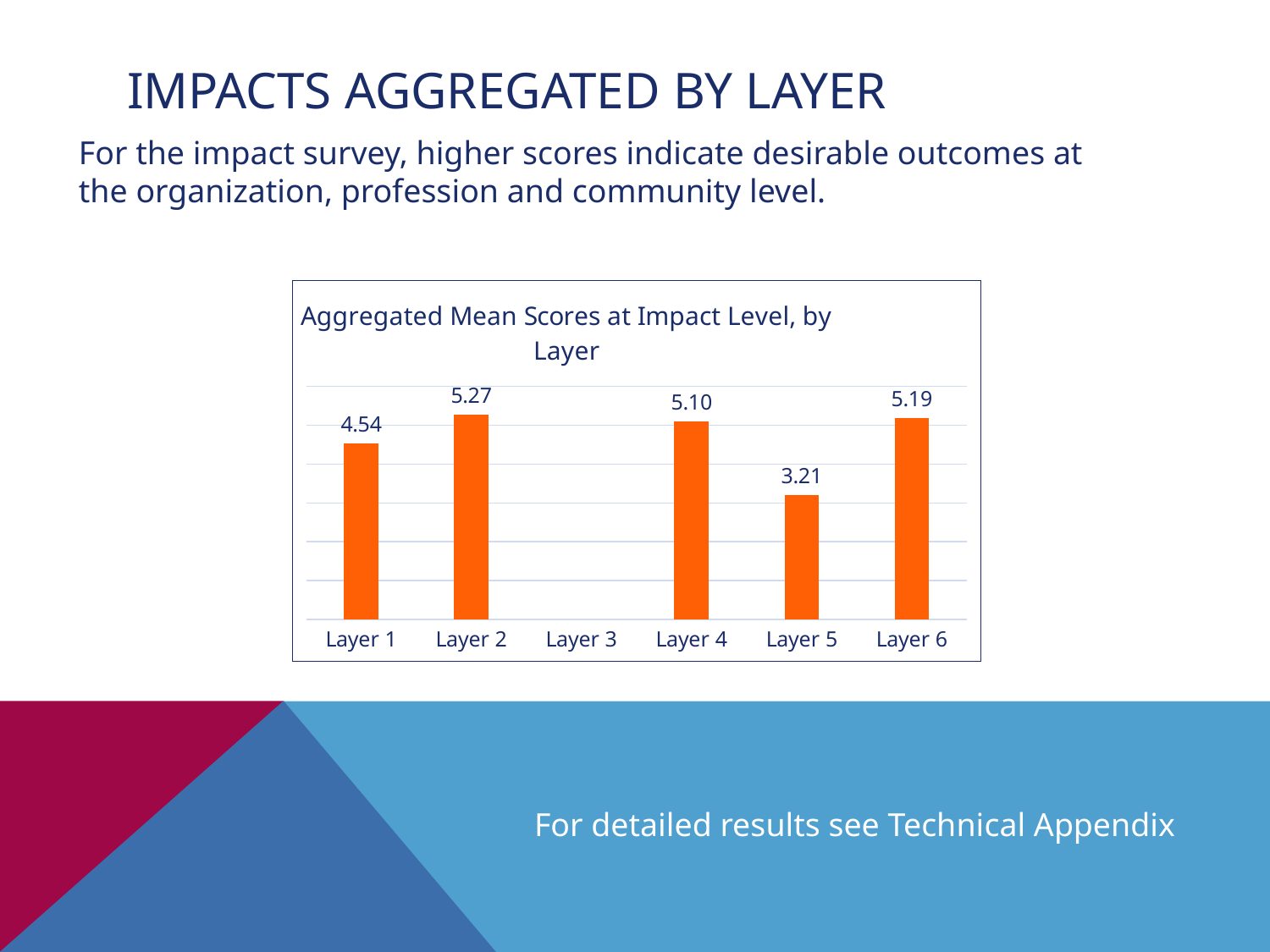
What is the aggregated mean score for Layer 6? 5.19 How many layer categories are shown on the x axis of the chart? 6 Which layer on the x axis has no bar plotted? Layer 3 What is the difference between the scores for Layer 2 and Layer 5? 2.06 What is the difference between the scores for Layer 6 and Layer 1? 0.65 What is the aggregated mean score for Layer 1? 4.54 What is the aggregated mean score for Layer 5? 3.21 Which layer with a plotted bar has the lowest aggregated mean score? Layer 5 Which layer has the highest aggregated mean score? Layer 2 What type of chart is shown on the slide? Bar chart Which has a higher aggregated mean score, Layer 1 or Layer 4? Layer 4 What is the aggregated mean score for Layer 4? 5.10